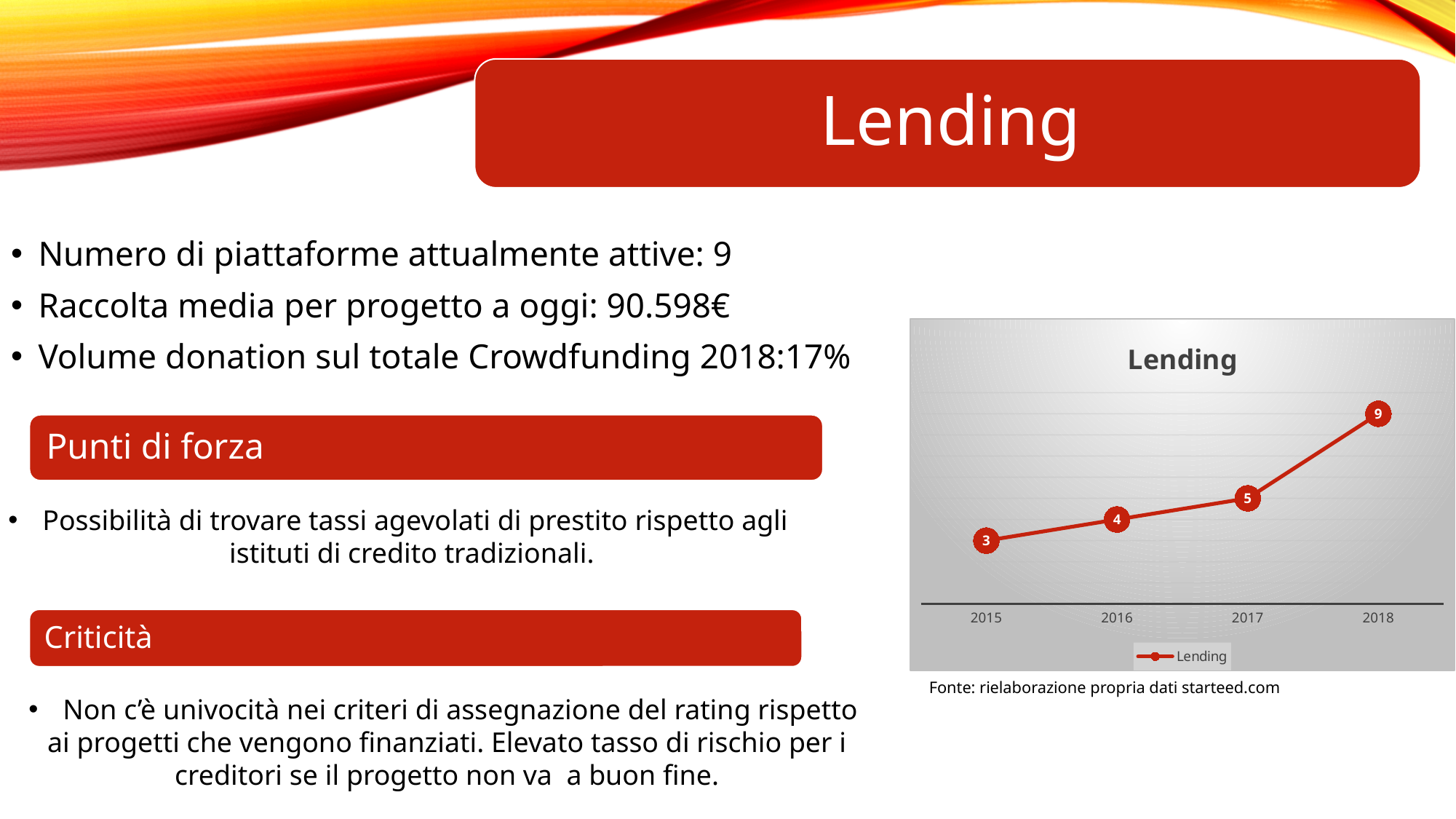
Which year has the lowest value in the Lending chart? 2015 How many series does the legend of the Lending chart list? 1 Which year has the highest value in the Lending chart? 2018 Do the values in the Lending chart rise or fall from 2015 to 2018? rise How many years are plotted in the Lending chart? 4 What is the value for 2017 in the Lending chart? 5 What kind of chart is the Lending chart? line chart What is the value for 2015 in the Lending chart? 3 What is the difference between the 2018 and 2017 values in the Lending chart? 4 What is the value for 2016 in the Lending chart? 4 What is the value for 2018 in the Lending chart? 9 Which is larger in the Lending chart, the value for 2016 or the value for 2017? 2017